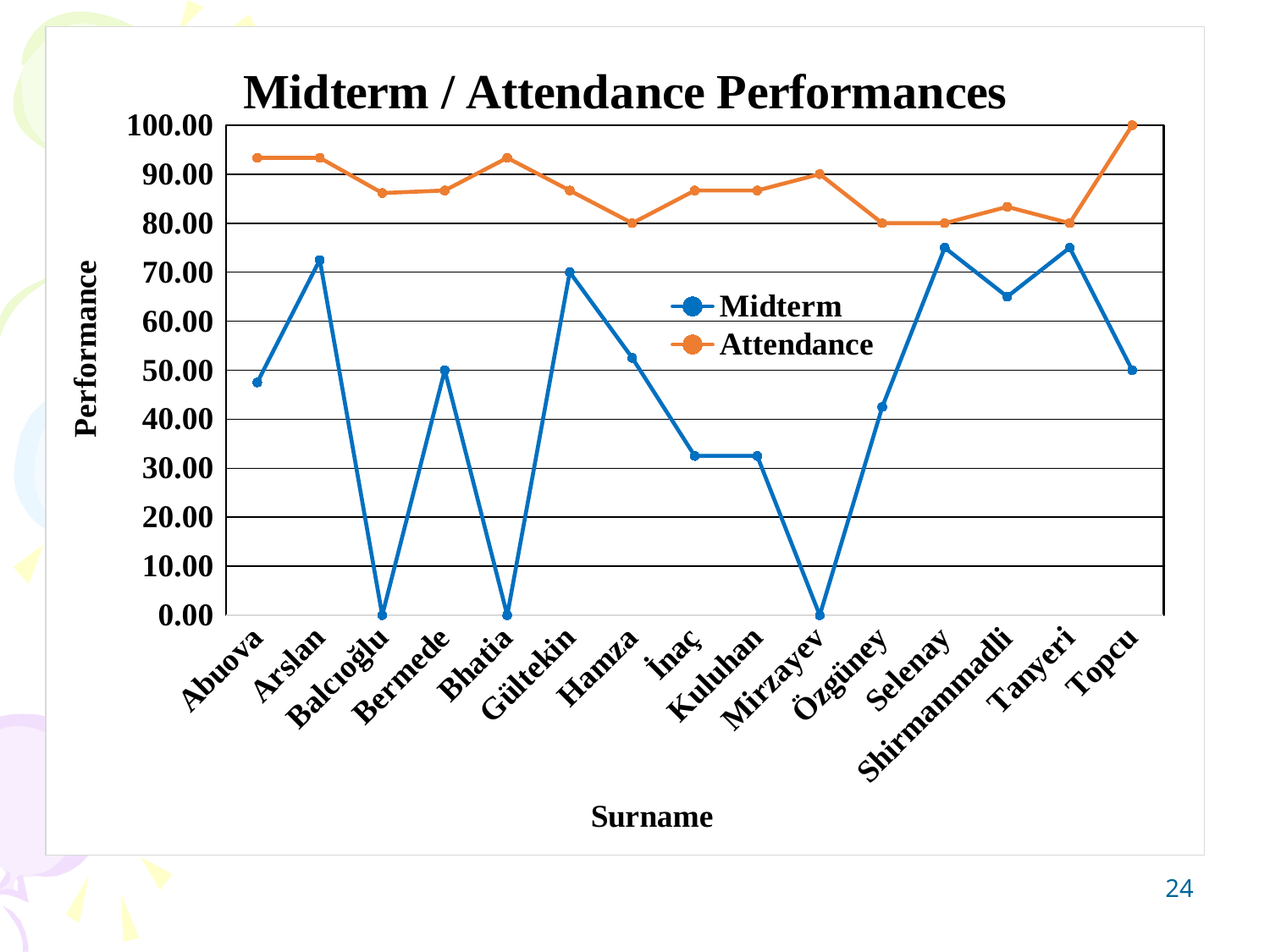
Which is larger, the Midterm value for Arslan or the Midterm value for Abuova? Arslan Is the Attendance value for Abuova greater or less than 90.00? greater What is the Midterm value for Balcıoğlu? 0.00 How many surnames are plotted along the x axis? 15 How many series does the legend list? 2 What is the Attendance value for Topcu? 100.00 Is the Midterm value for İnaç greater or less than 40.00? less What is the Attendance value for Hamza? 80.00 What kind of chart is shown on the slide? Line chart What is the Midterm value for Gültekin? 70.00 Which surname has the highest Attendance value? Topcu What is the title of the chart? Midterm / Attendance Performances